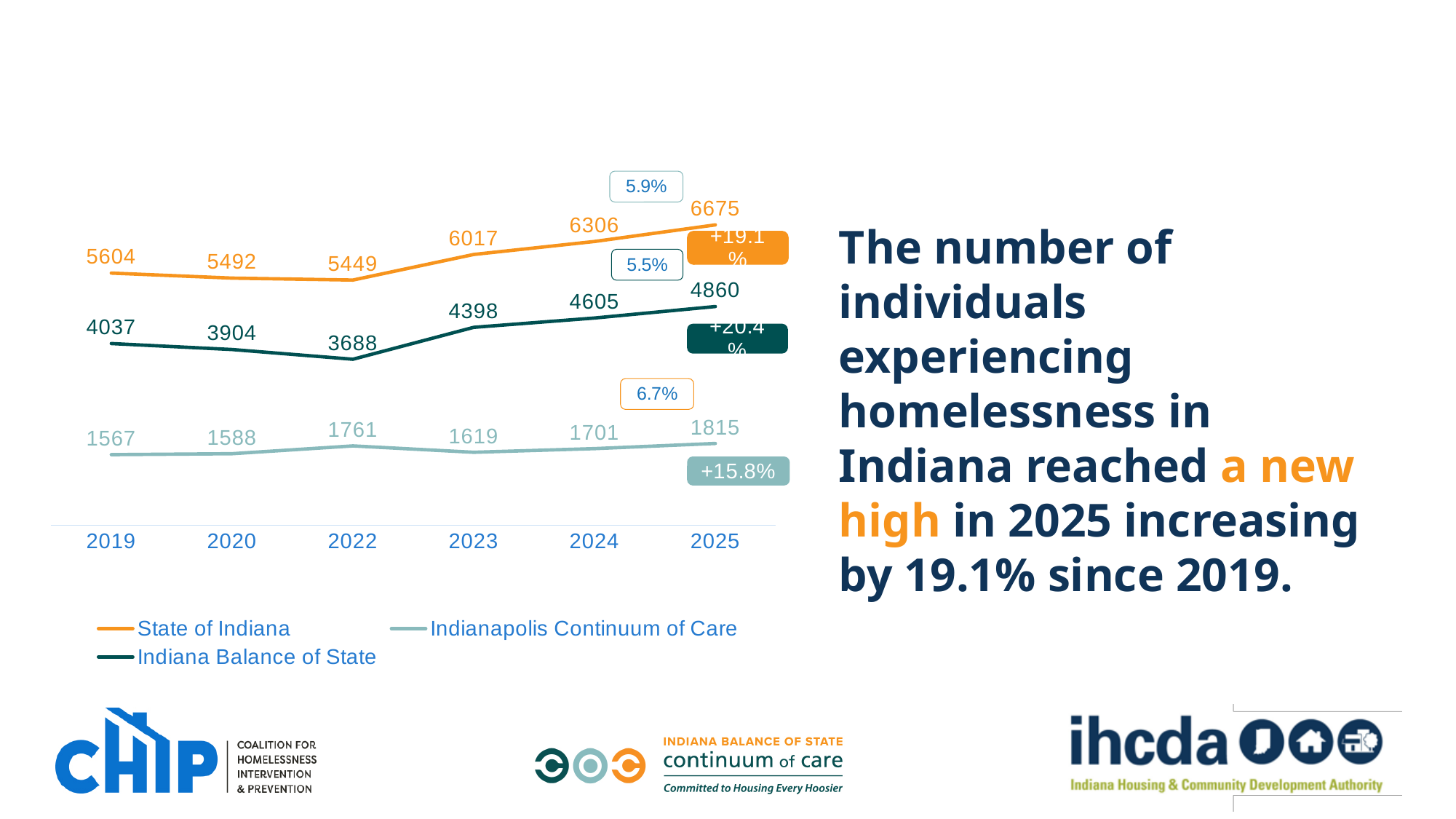
In which year is the State of Indiana value lowest? 2022 Which is larger: the Indianapolis Continuum of Care value in 2022 or in 2023? 2022 What is the difference between the State of Indiana values in 2025 and 2024? 369 What type of chart is shown on the slide? line chart In which year is the Indiana Balance of State value highest? 2025 How many series does the legend list? 3 What is the value for Indiana Balance of State in 2022? 3688 What is the value for Indianapolis Continuum of Care in 2024? 1701 What is the value for State of Indiana in 2025? 6675 Does the State of Indiana series rise or fall from 2022 to 2025? rise How many years are shown on the x axis? 6 What colour is the line for Indiana Balance of State? dark green